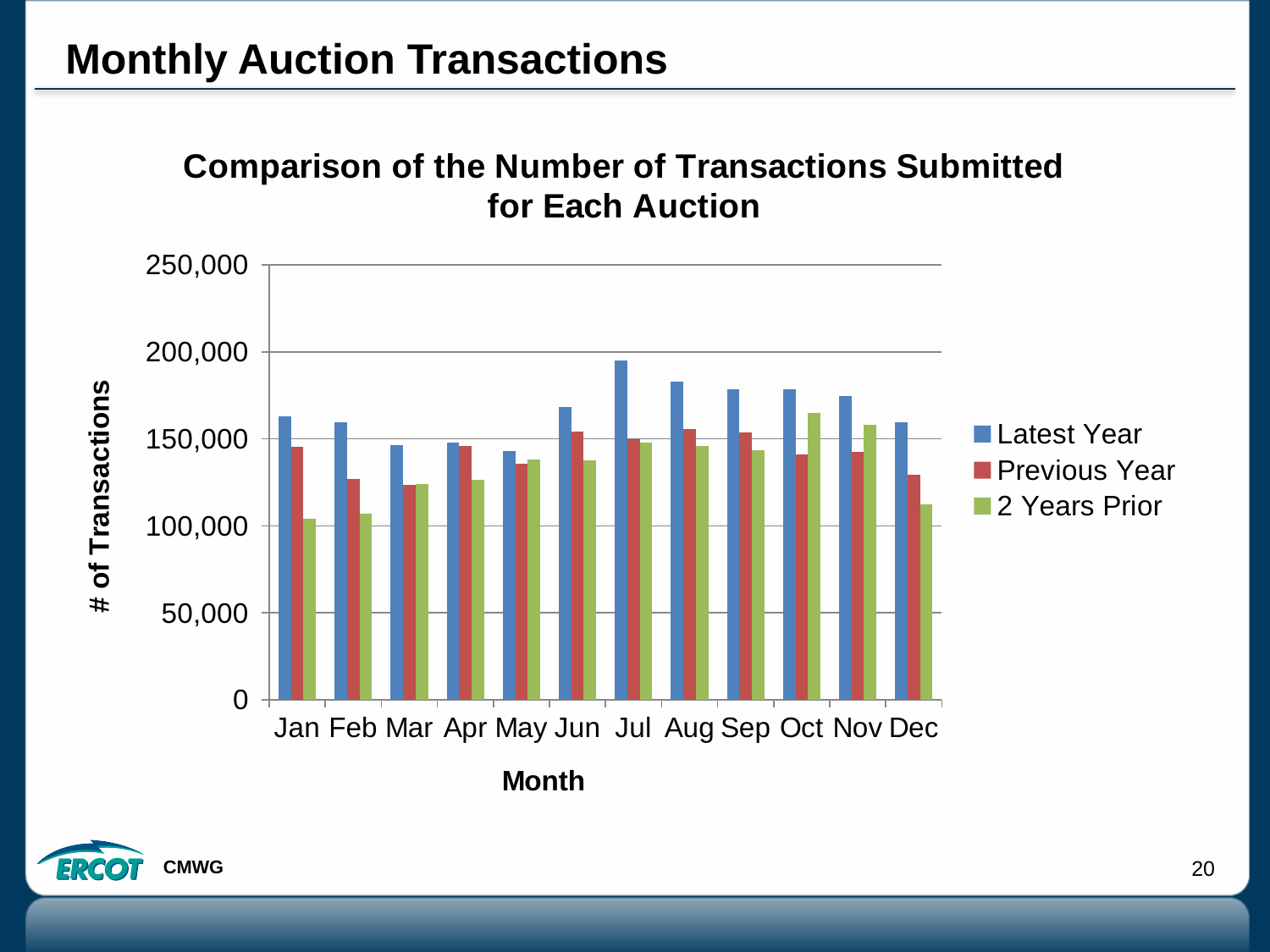
What is the title of the chart? Comparison of the Number of Transactions Submitted for Each Auction In which month is the Latest Year value highest? Jul In Oct, which is larger: the Previous Year value or the 2 Years Prior value? 2 Years Prior What kind of chart is shown on the slide? Bar chart In Jan, which is larger: the Latest Year value or the 2 Years Prior value? Latest Year How many months are shown on the x axis? 12 Is the Latest Year value for Jul greater or less than 150,000? greater Is the Previous Year value for Feb greater or less than 100,000? greater Is the 2 Years Prior value for Jan greater or less than 150,000? less How many series does the legend list? 3 In which month is the 2 Years Prior value highest? Oct